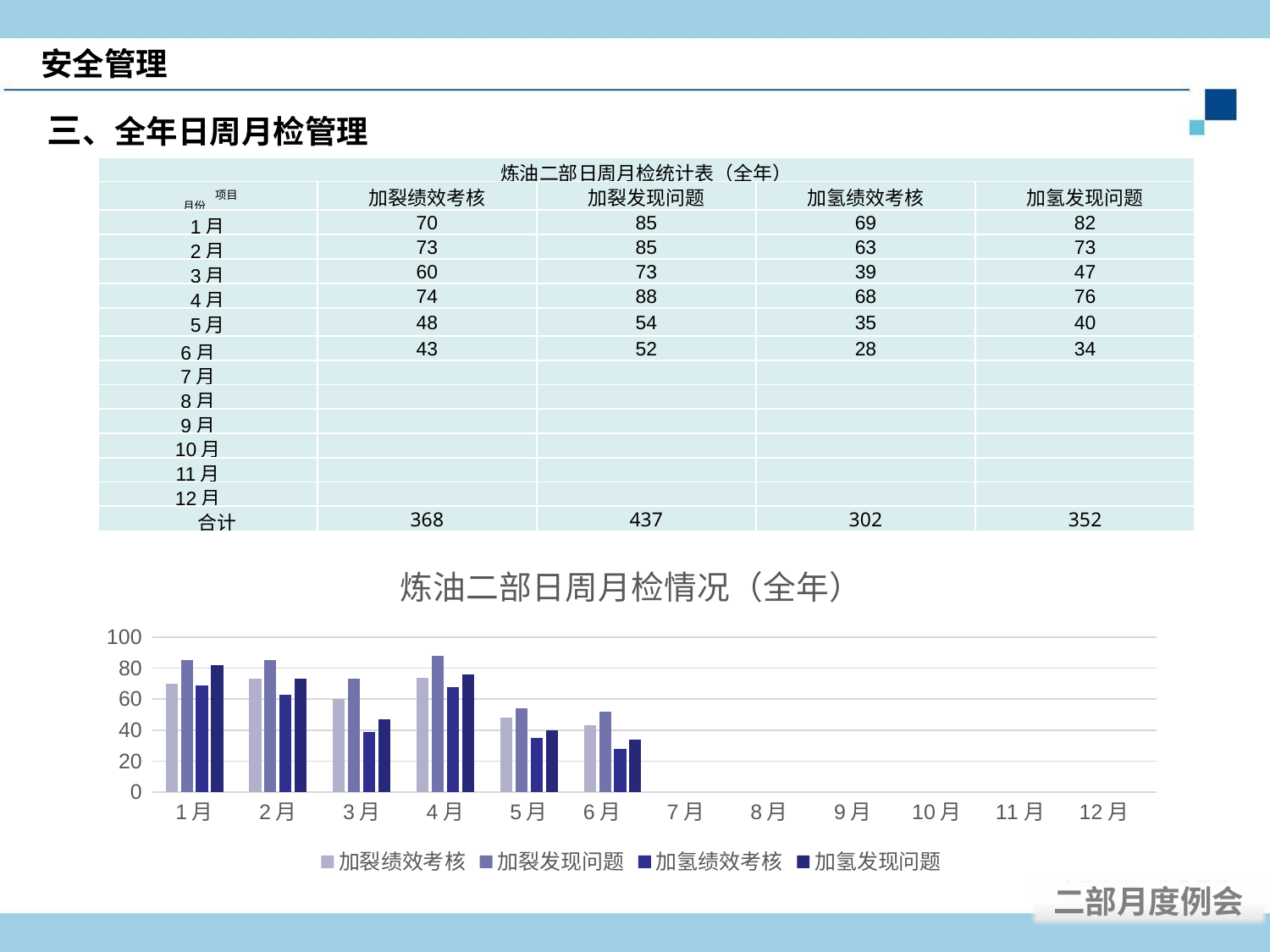
What is the value of 加氢发现问题 in 2月? 73 In which month is 加氢绩效考核 lowest? 6月 What is the difference between 加裂发现问题 and 加裂绩效考核 in 1月? 15 What kind of chart is shown on the slide? bar chart Which series has the highest value in 3月? 加裂发现问题 How many month categories are shown on the x axis of the chart? 12 Does 加氢绩效考核 rise or fall from 4月 to 6月? fall Is the value for 加裂绩效考核 in 5月 greater or less than 60? less What is the title of the chart? 炼油二部日周月检情况（全年） What is the value of 加裂发现问题 in 4月? 88 In 1月, which is larger: 加氢发现问题 or 加氢绩效考核? 加氢发现问题 How many series does the chart legend list? 4